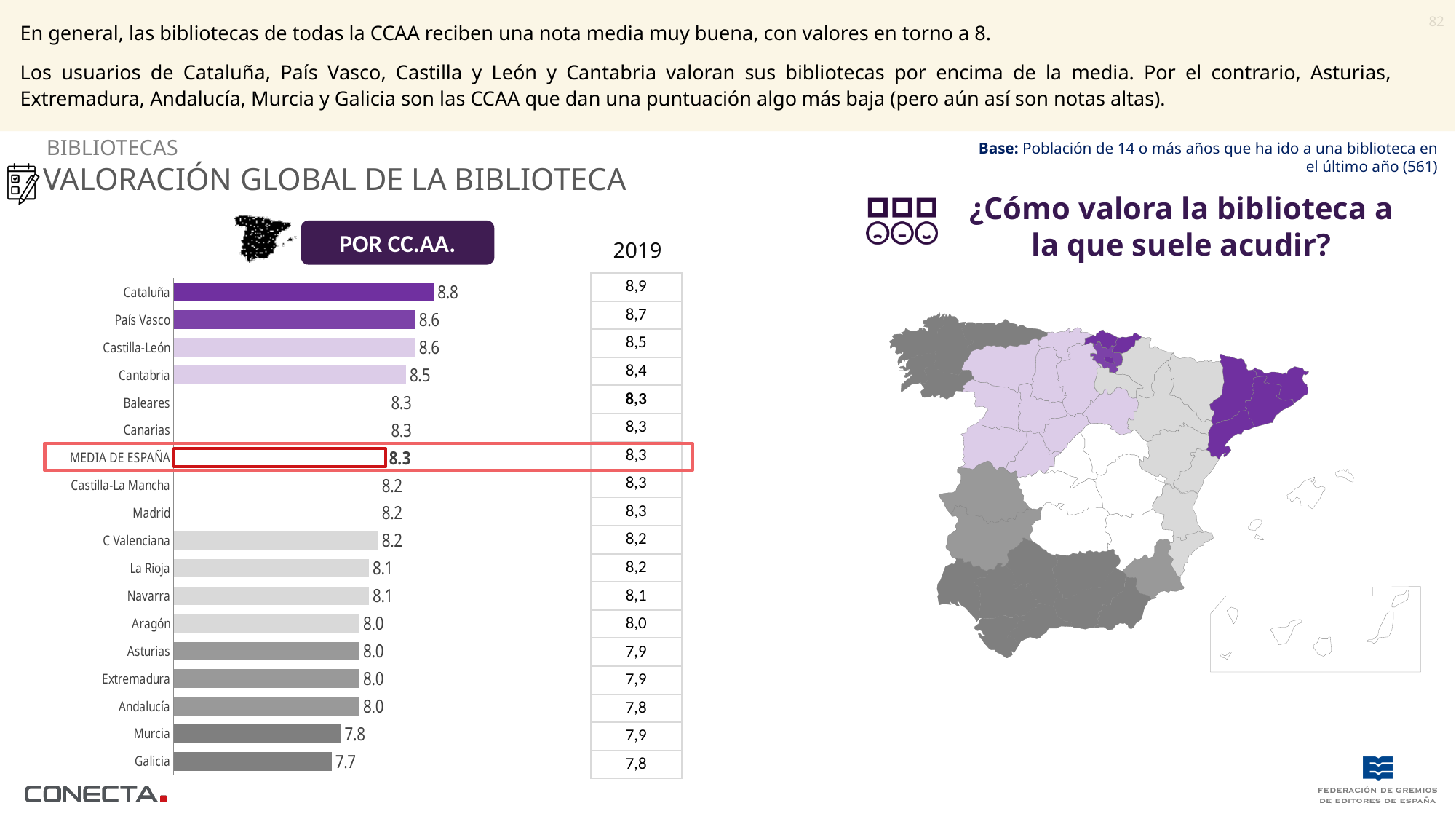
What is the difference between the values for Cataluña and Galicia in the bar chart? 1.1 What is the value shown for Galicia in the bar chart? 7.7 What is the value shown for Cataluña in the bar chart? 8.8 What is the 2019 value shown in the table column for Cataluña? 8,9 What year is shown as the header of the column of values to the right of the bar chart? 2019 Which has a higher value in the bar chart, Cantabria or Murcia? Cantabria What kind of chart is used to show the valuation by CC.AA.? Bar chart How many autonomous communities (excluding MEDIA DE ESPAÑA) are listed in the bar chart? 17 Which category has the lowest value in the bar chart? Galicia What is the difference between the values for País Vasco and Murcia in the bar chart? 0.8 What is the value shown for MEDIA DE ESPAÑA in the bar chart? 8.3 Which category has the highest value in the bar chart? Cataluña